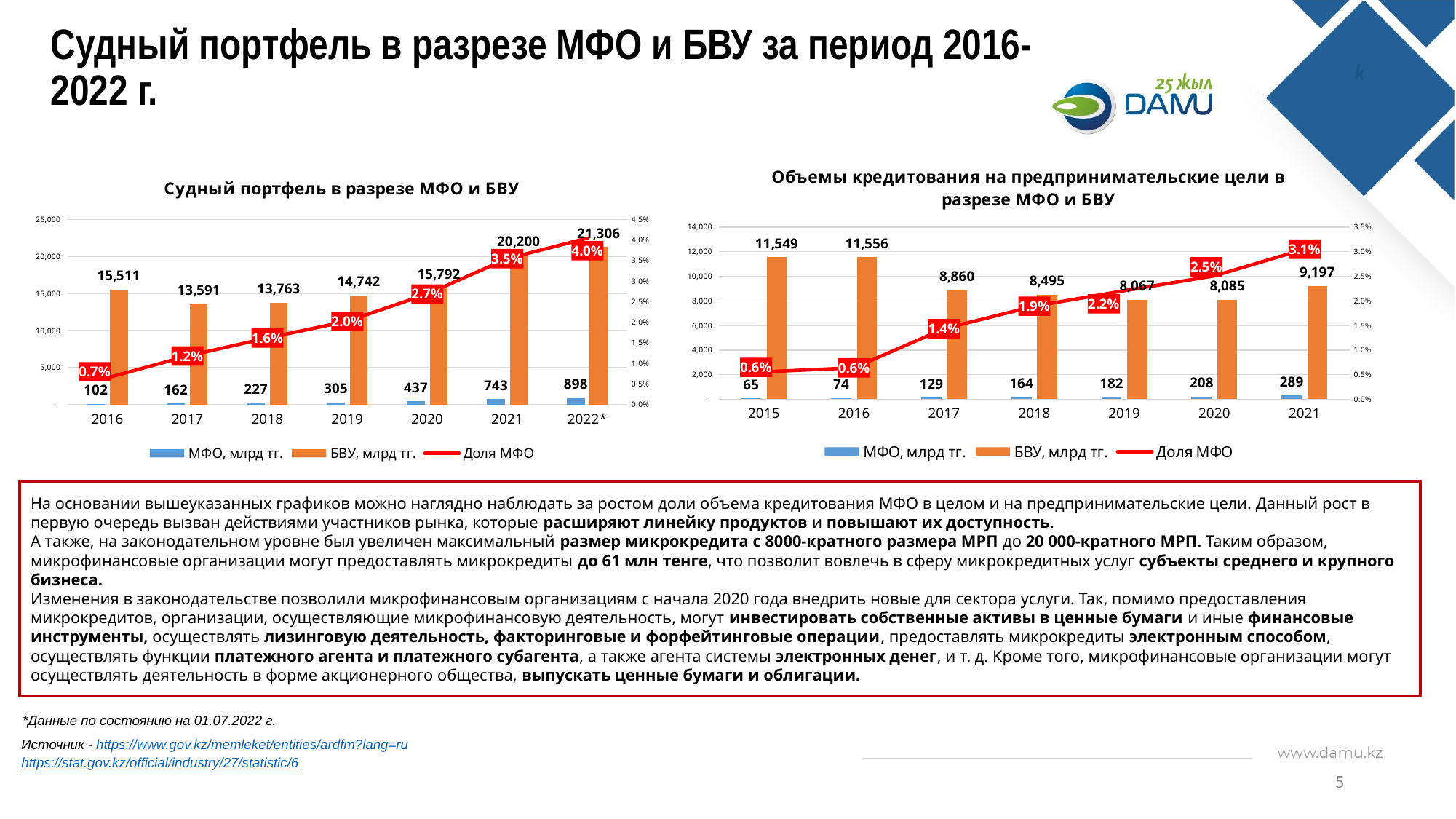
In the right chart 'Объемы кредитования на предпринимательские цели в разрезе МФО и БВУ', which year has the highest МФО, млрд тг. value? 2021 In the left chart 'Судный портфель в разрезе МФО и БВУ', what is the Доля МФО for 2022*? 4.0% In the left chart 'Судный портфель в разрезе МФО и БВУ', which year has the lowest БВУ, млрд тг. value? 2017 In the right chart 'Объемы кредитования на предпринимательские цели в разрезе МФО и БВУ', what is the Доля МФО for 2019? 2.2% In the left chart 'Судный портфель в разрезе МФО и БВУ', does the Доля МФО line rise or fall from 2016 to 2022*? rise In the left chart 'Судный портфель в разрезе МФО и БВУ', what is the value of МФО, млрд тг. for 2019? 305 In the right chart 'Объемы кредитования на предпринимательские цели в разрезе МФО и БВУ', which is larger: the БВУ value for 2015 or for 2021? 2015 In the right chart 'Объемы кредитования на предпринимательские цели в разрезе МФО и БВУ', what is the value of БВУ, млрд тг. for 2017? 8,860 In the right chart 'Объемы кредитования на предпринимательские цели в разрезе МФО и БВУ', how many years are shown on the x axis? 7 How many series does the legend of the left chart 'Судный портфель в разрезе МФО и БВУ' list? 3 In the left chart 'Судный портфель в разрезе МФО и БВУ', what is the value of БВУ, млрд тг. for 2021? 20,200 In the left chart 'Судный портфель в разрезе МФО и БВУ', what is the difference between the МФО values for 2022* and 2021? 155